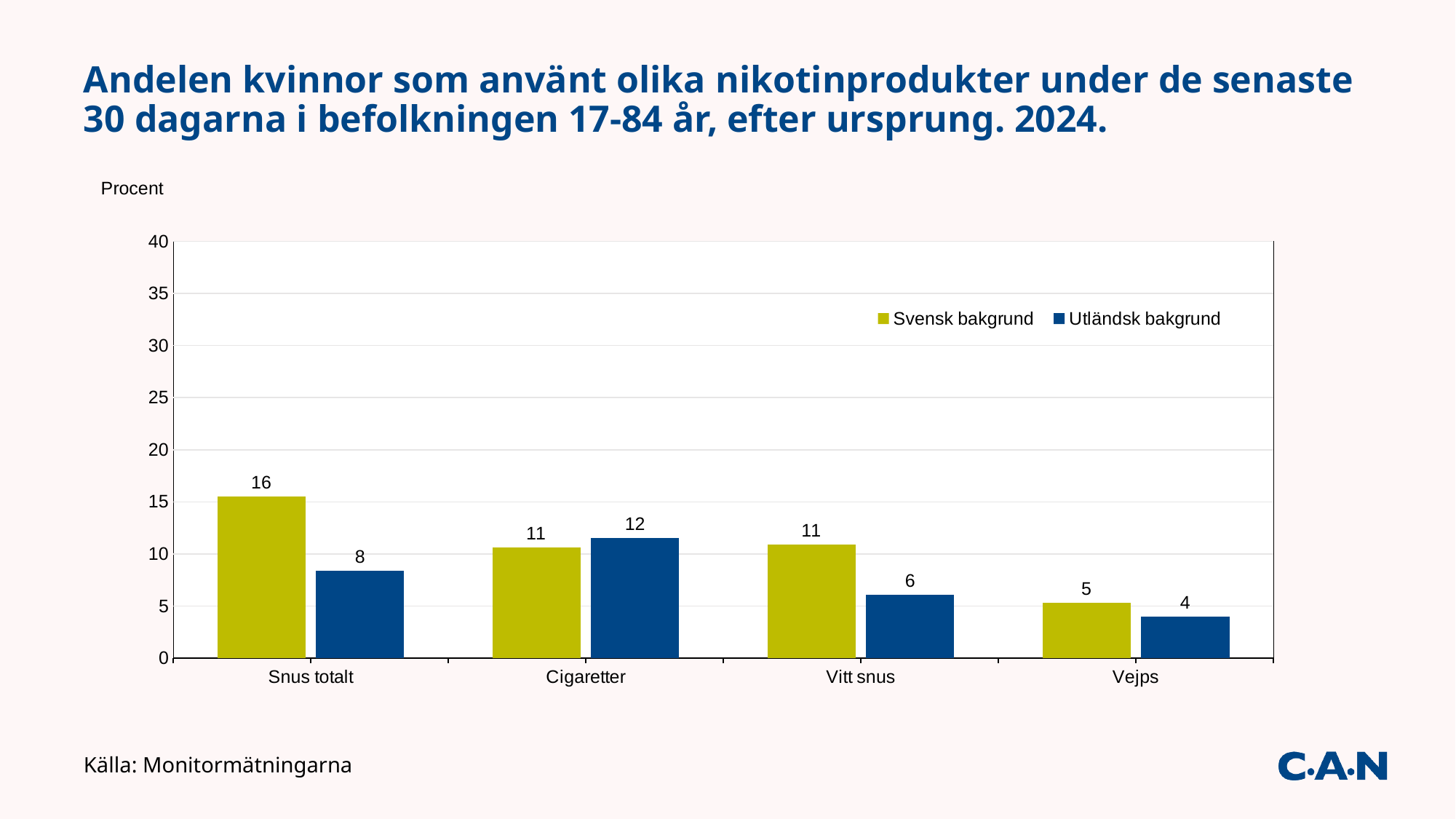
How many categories are shown on the x axis? 4 How many series does the legend list? 2 What is the label on the y axis? Procent What is the value for Svensk bakgrund in the Snus totalt category? 16 What is the value for Utländsk bakgrund in the Cigaretter category? 12 Is the value for Svensk bakgrund in the Vitt snus category greater or less than 20? less What kind of chart is shown on the slide? bar chart Which category has the highest value for Svensk bakgrund? Snus totalt What is the value for Utländsk bakgrund in the Vejps category? 4 What is the difference between Svensk bakgrund and Utländsk bakgrund in the Snus totalt category? 8 In the Cigaretter category, which series has the larger value, Svensk bakgrund or Utländsk bakgrund? Utländsk bakgrund Which category has the lowest value for Utländsk bakgrund? Vejps